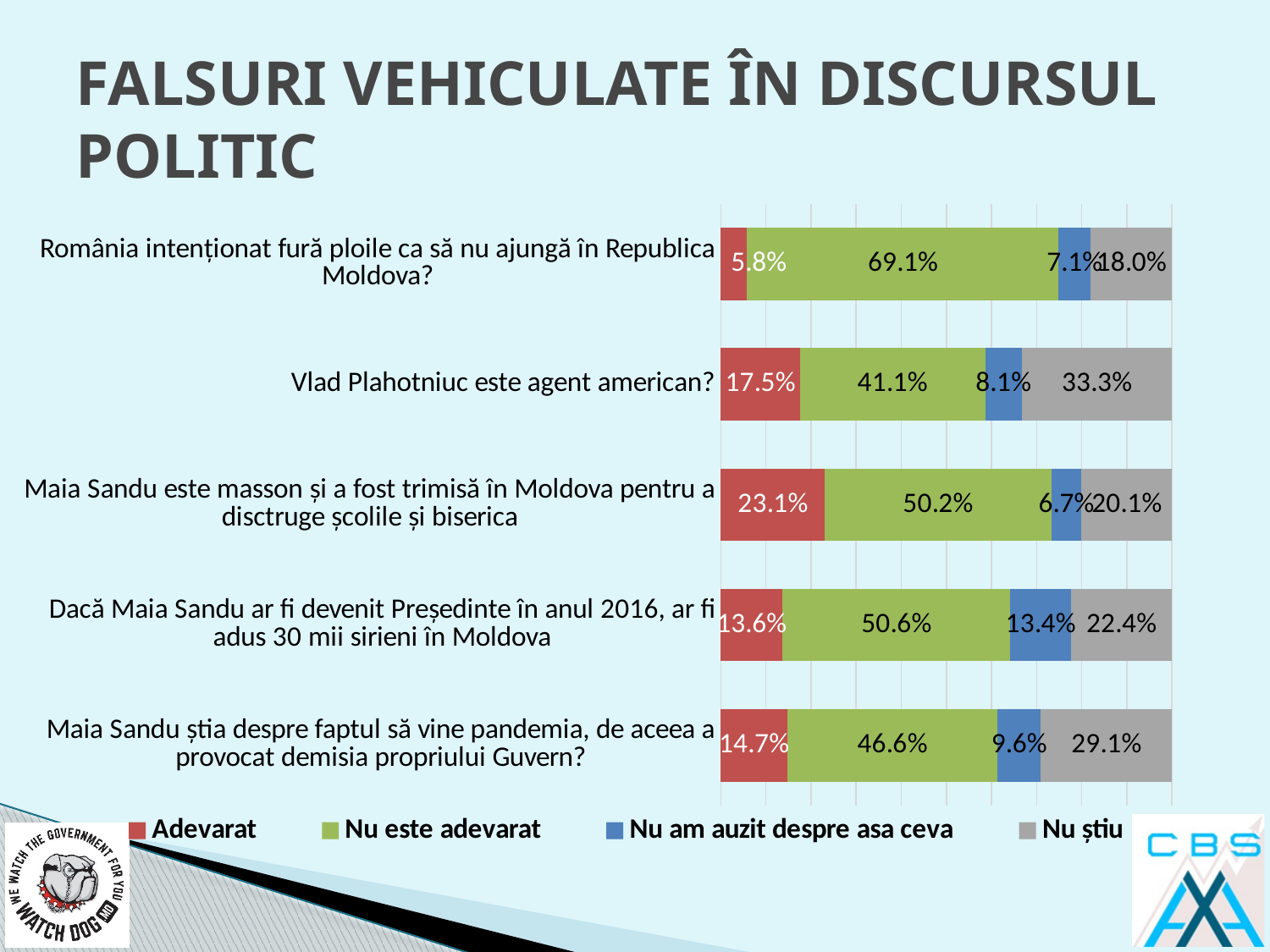
What is the difference between the "Nu știu" values for "Vlad Plahotniuc este agent american?" and the statement about România stealing the rains? 15.3% Which statement has the highest "Adevarat" share? Maia Sandu este masson și a fost trimisă în Moldova pentru a disctruge școlile și biserica What type of chart is shown on the slide? Stacked bar chart Which statement has the lowest "Adevarat" share? România intenționat fură ploile ca să nu ajungă în Republica Moldova? What percentage of respondents answered "Adevarat" for the statement "Vlad Plahotniuc este agent american?" 17.5% What is the "Nu știu" value for the statement "Maia Sandu știa despre faptul să vine pandemia, de aceea a provocat demisia propriului Guvern?" 29.1% Which is larger: the "Nu este adevarat" value for the statement about Maia Sandu being a masson, or for the statement about Maia Sandu knowing about the pandemic? Maia Sandu este masson (50.2%) How many statements (categories) are shown in the chart? 5 How many series does the legend list? 4 Which legend entry is shown in green? Nu este adevarat What is the "Nu este adevarat" value for the statement about România stealing the rains so they do not reach Republica Moldova? 69.1% What is the "Nu am auzit despre asa ceva" value for the statement about Maia Sandu bringing 30 mii sirieni to Moldova if she had become President in 2016? 13.4%